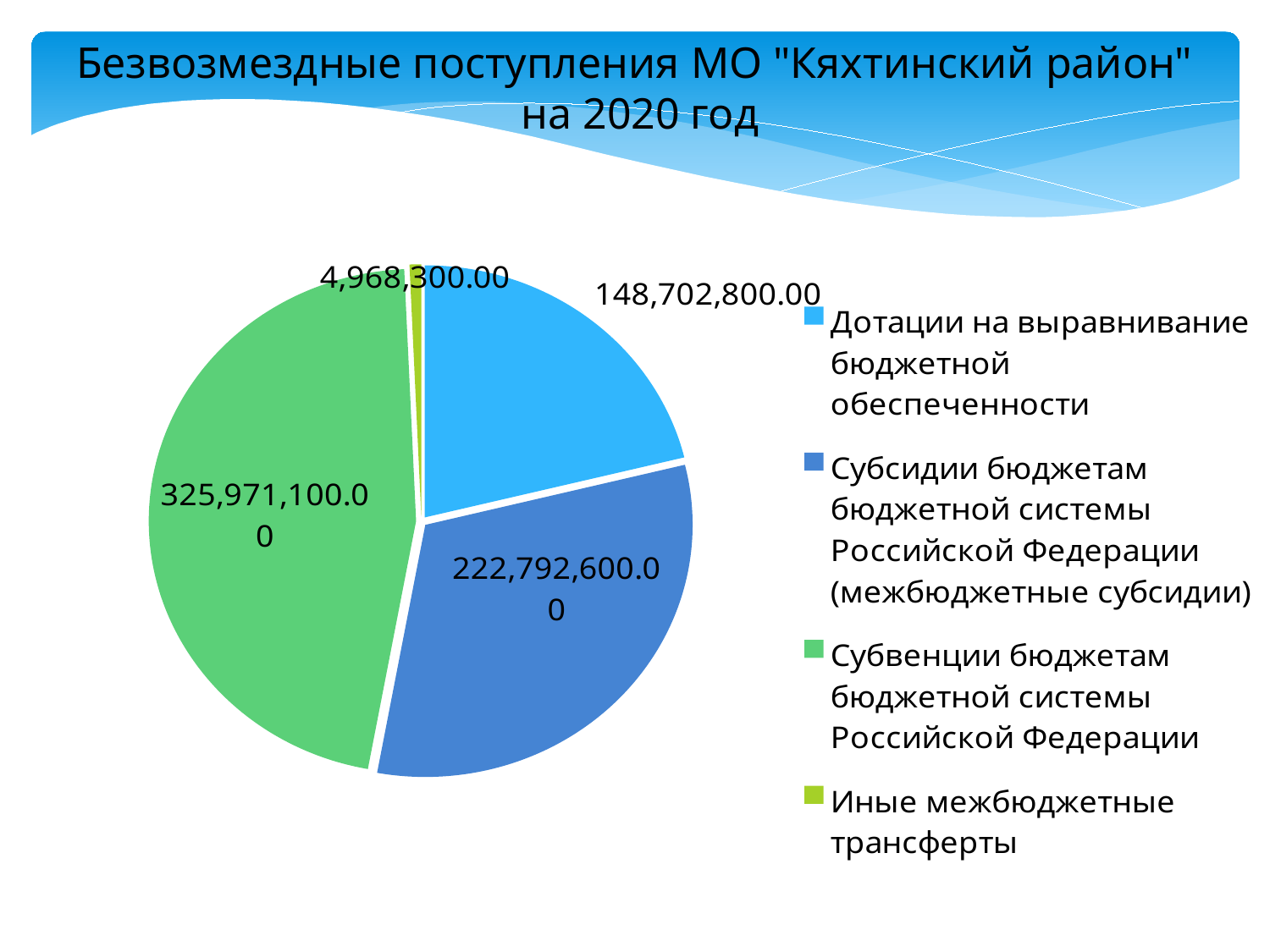
What is the value for Дотации на выравнивание бюджетной обеспеченности? 148,702,800.00 What is the value for Иные межбюджетные трансферты? 4,968,300.00 What is the value for Субсидии бюджетам бюджетной системы Российской Федерации (межбюджетные субсидии)? 222,792,600.00 What is the total of all slices in the pie chart? 702,434,800.00 Which category has the largest slice of the pie? Субвенции бюджетам бюджетной системы Российской Федерации What is the difference between the value for Субвенции бюджетам бюджетной системы Российской Федерации and the value for Субсидии бюджетам бюджетной системы Российской Федерации (межбюджетные субсидии)? 103,178,500.00 What is the title of the slide? Безвозмездные поступления МО "Кяхтинский район" на 2020 год What is the value for Субвенции бюджетам бюджетной системы Российской Федерации? 325,971,100.00 What type of chart is shown on the slide? pie chart Which category has the smallest slice of the pie? Иные межбюджетные трансферты Which is larger: the value for Дотации на выравнивание бюджетной обеспеченности or the value for Субсидии бюджетам бюджетной системы Российской Федерации (межбюджетные субсидии)? Субсидии бюджетам бюджетной системы Российской Федерации (межбюджетные субсидии) How many categories does the pie chart have? 4